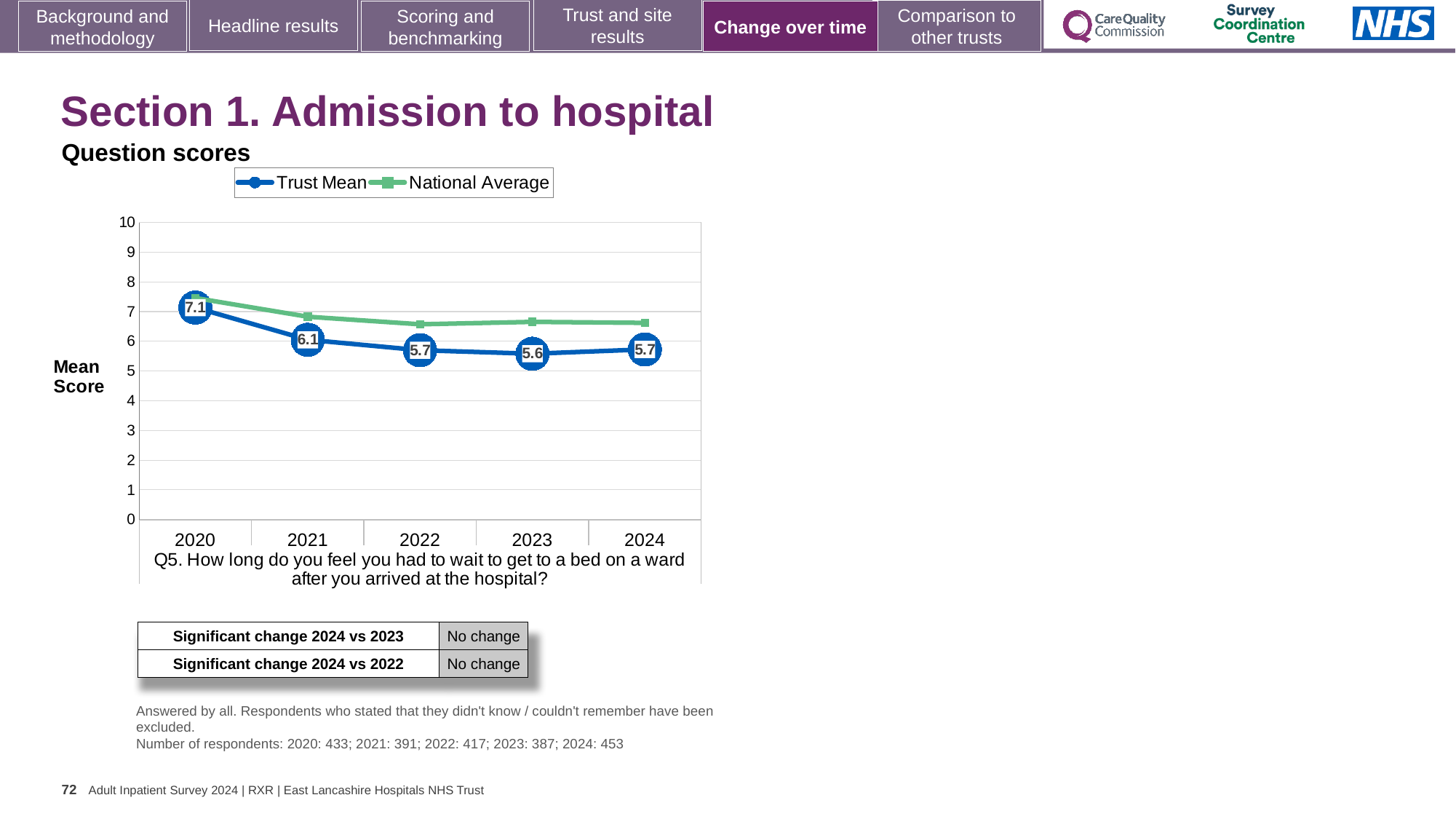
What is the Trust Mean score for 2024? 5.7 In which year is the Trust Mean score highest? 2020 What is the Trust Mean score for 2020? 7.1 In which year is the Trust Mean score lowest? 2023 What kind of chart is shown on the slide? Line chart What is the Trust Mean score for 2023? 5.6 How many series does the chart legend list? 2 Is the National Average value for 2020 greater or less than 7? greater What is the difference between the Trust Mean score in 2020 and in 2021? 1.0 How many years are shown on the x axis of the chart? 5 Is the National Average value for 2023 greater or less than 7? less Which is larger, the Trust Mean score in 2021 or in 2022? 2021